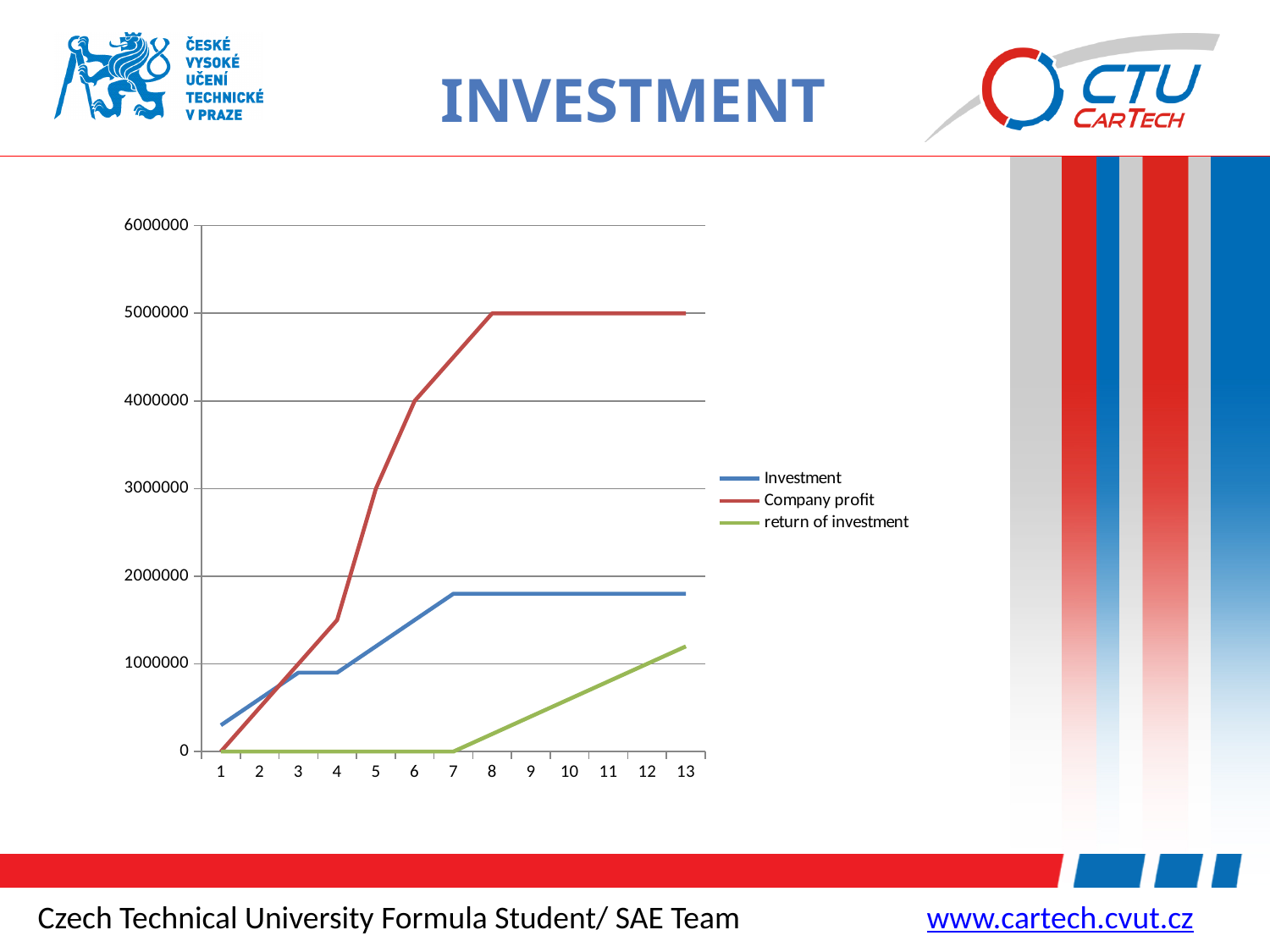
How many series does the legend list? 3 Which series has the lowest value at point 13? return of investment What is the value of Company profit at point 13? 5000000 Is the value of Company profit at point 4 greater or less than 2000000? less Is the value of return of investment at point 13 greater or less than 1000000? greater Does the Company profit line rise or fall from point 1 to point 8? rise At point 13, which is larger: Investment or return of investment? Investment What kind of chart is shown on the slide? line chart What is the value of return of investment at point 5? 0 How many points are on the x axis of the chart? 13 Which series has the highest value at point 13? Company profit Is the value of Investment at point 13 greater or less than 2000000? less